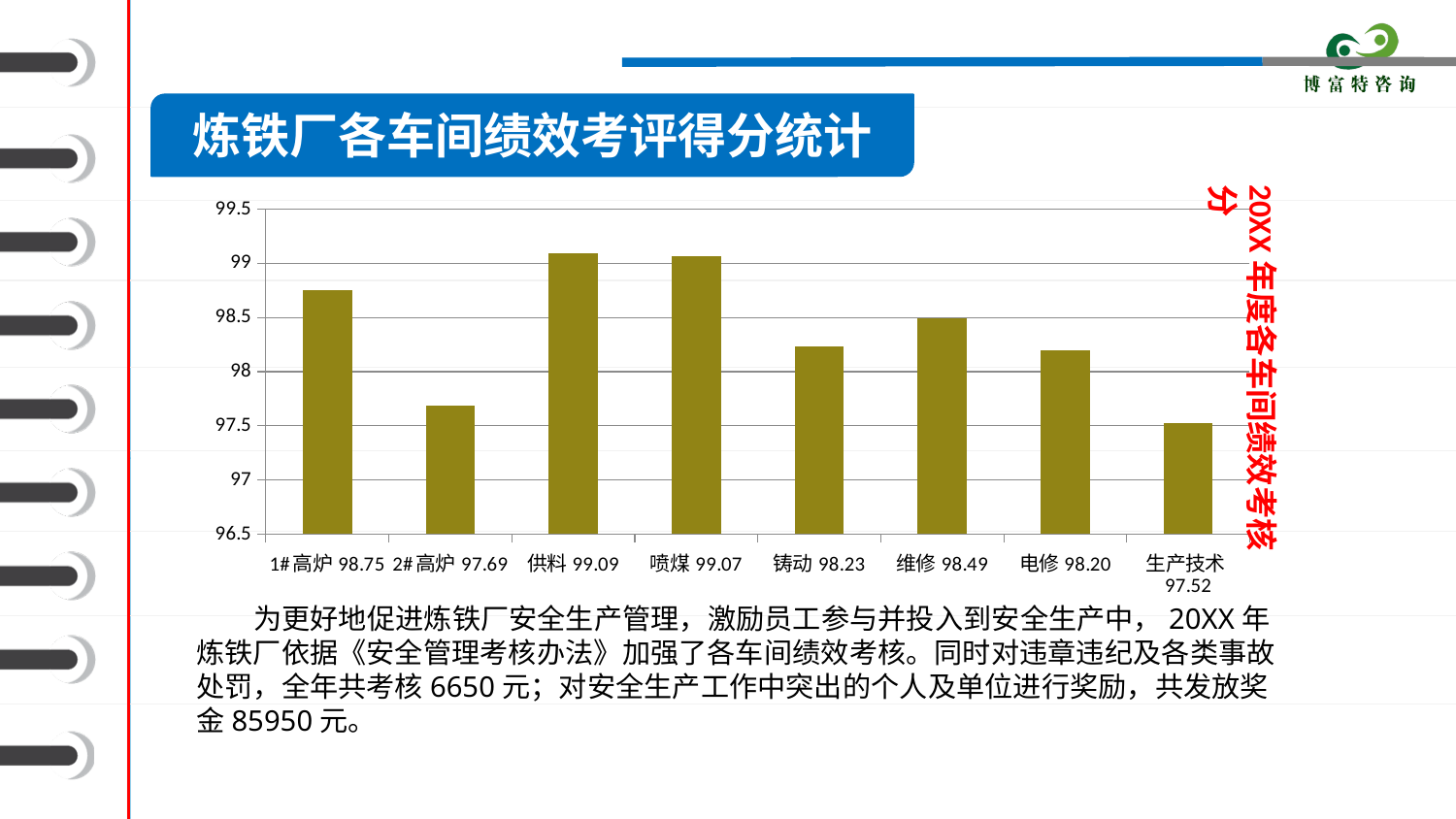
Is the value for 2#高炉 greater or less than 98? less Which has a higher score, 维修 or 铸动? 维修 Which workshop has the lowest score? 生产技术 What is the difference between the scores of 供料 and 生产技术? 1.57 How many workshops are shown in the chart? 8 What is the difference between the scores of 1#高炉 and 2#高炉? 1.06 What is the score for 喷煤? 99.07 What is the score for 电修? 98.20 What is the score for 1#高炉? 98.75 What kind of chart is shown on the slide? bar chart Which workshop has the highest score? 供料 What is the score for 生产技术? 97.52